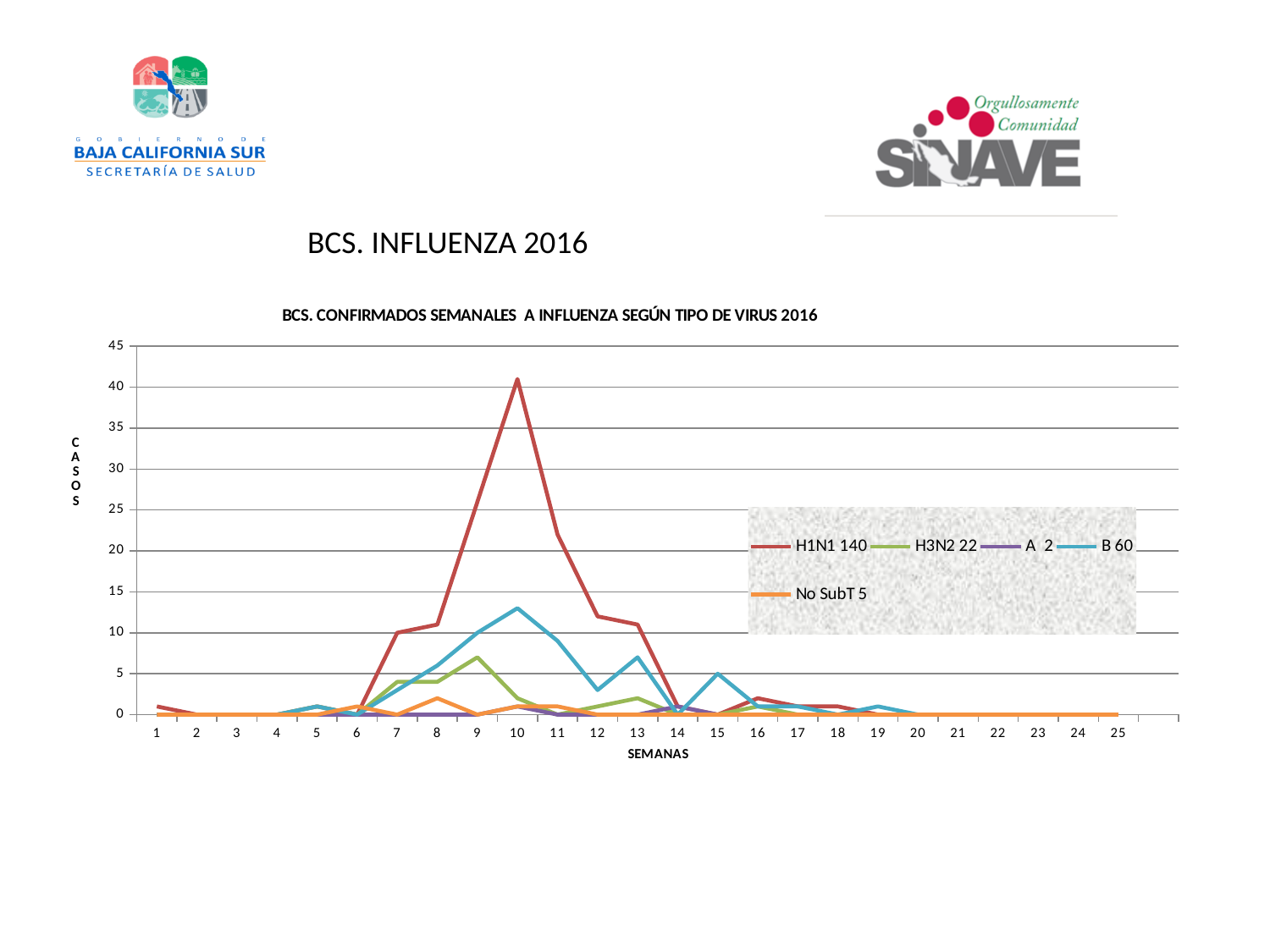
In week 10, which series has the larger value, H1N1 140 or B 60? H1N1 140 How many series does the legend list? 5 Is the value for B 60 in week 10 greater or less than 10? greater Which series reaches the highest peak in the chart? H1N1 140 Is the value for H1N1 140 in week 11 greater or less than 20? greater Does the H1N1 140 series rise or fall from week 10 to week 14? fall In which week does the H1N1 140 series reach its highest value? 10 What kind of chart is shown on the slide? line chart Is the value for H1N1 140 in week 10 greater or less than 35? greater What is the title of the chart? BCS. CONFIRMADOS SEMANALES A INFLUENZA SEGÚN TIPO DE VIRUS 2016 How many weeks are shown on the x axis? 25